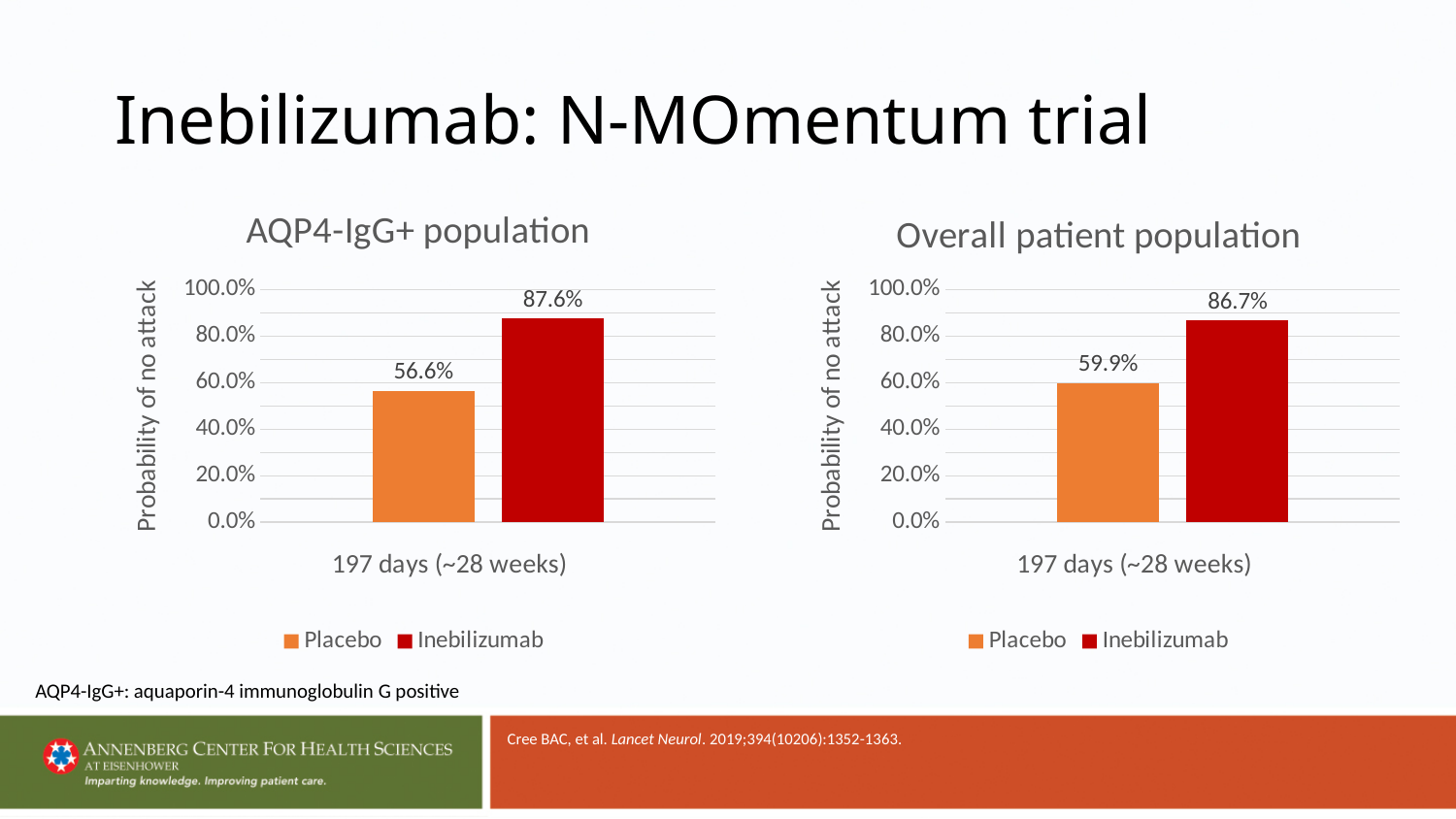
In the Overall patient population chart, which series has the lower probability of no attack? Placebo In the Overall patient population chart, what is the probability of no attack for Inebilizumab? 86.7% In the Overall patient population chart, what is the probability of no attack for Placebo? 59.9% What is the x-axis category label shown on the AQP4-IgG+ population chart? 197 days (~28 weeks) In the AQP4-IgG+ population chart, what is the probability of no attack for Placebo? 56.6% In the AQP4-IgG+ population chart, what is the probability of no attack for Inebilizumab? 87.6% What kind of chart is the Overall patient population chart? Bar chart In the AQP4-IgG+ population chart, what is the difference between the Inebilizumab and Placebo values? 31.0% How many series does the legend of the AQP4-IgG+ population chart list? 2 In the Overall patient population chart, what is the difference between the Inebilizumab and Placebo values? 26.8% In the AQP4-IgG+ population chart, which series has the higher probability of no attack? Inebilizumab Is the Placebo value in the Overall patient population chart greater or less than 60.0%? less